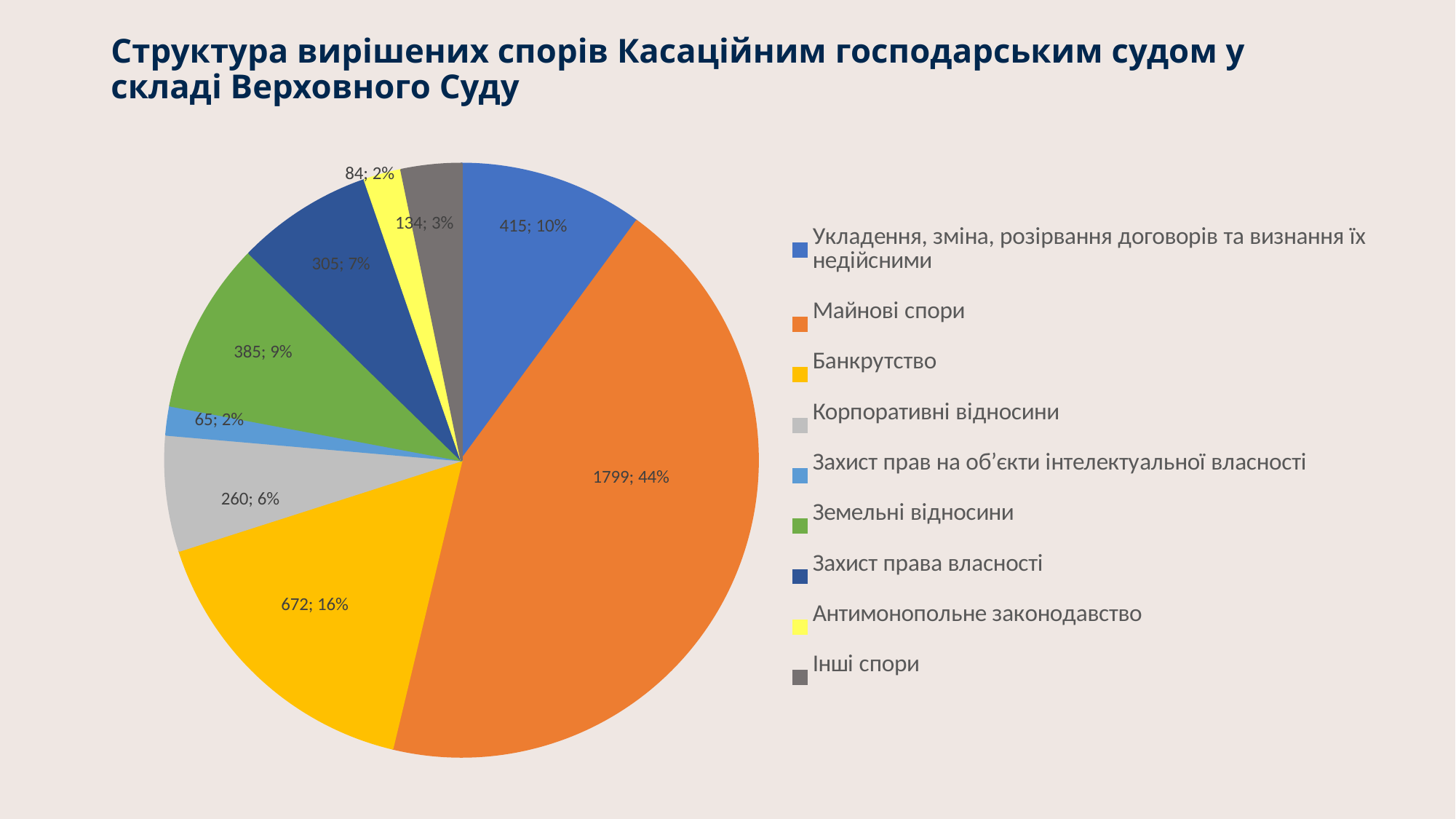
What kind of chart is shown on the slide? pie chart What is the value shown for Земельні відносини? 385 What is the value shown for Банкрутство? 672 Which is larger, the value for Корпоративні відносини or the value for Захист права власності? Захист права власності Which category has the smallest value in the pie chart? Захист прав на об’єкти інтелектуальної власності What is the value shown for Захист права власності? 305 Which category has the largest slice of the pie? Майнові спори How many slices does the pie chart have? 9 What share of the pie does Банкрутство represent? 16% What share of the pie does Інші спори represent? 3% What is the value shown for Майнові спори? 1799 What is the difference between the values for Майнові спори and Банкрутство? 1127